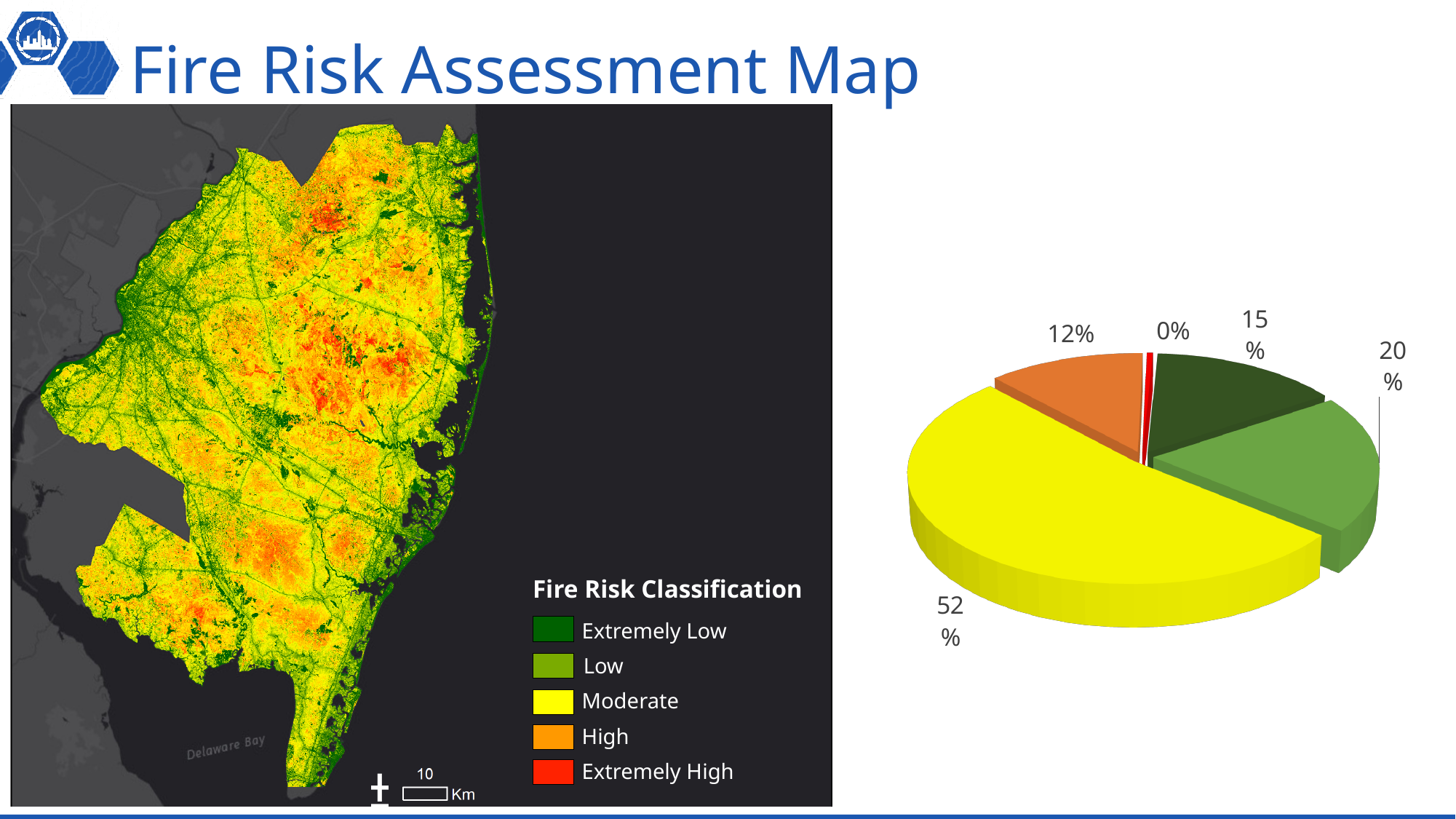
What is the title of the legend shown on the map? Fire Risk Classification In the pie chart, which is larger: the light green slice or the dark green slice? the light green slice (20%) Which slice of the pie chart is the smallest? the red slice (0%) In the pie chart, what percentage is shown for the yellow slice? 52% In the pie chart, what percentage is shown for the red slice? 0% In the pie chart, what is the difference between the yellow slice and the orange slice? 40 percentage points What kind of chart is shown on the right side of the slide? pie chart How many slices does the pie chart on the right have? 5 Which slice of the pie chart is the largest? the yellow slice (52%) In the pie chart, what percentage is shown for the orange slice? 12% In the pie chart, what percentage is shown for the dark green slice? 15% In the pie chart, what percentage is shown for the light green slice? 20%